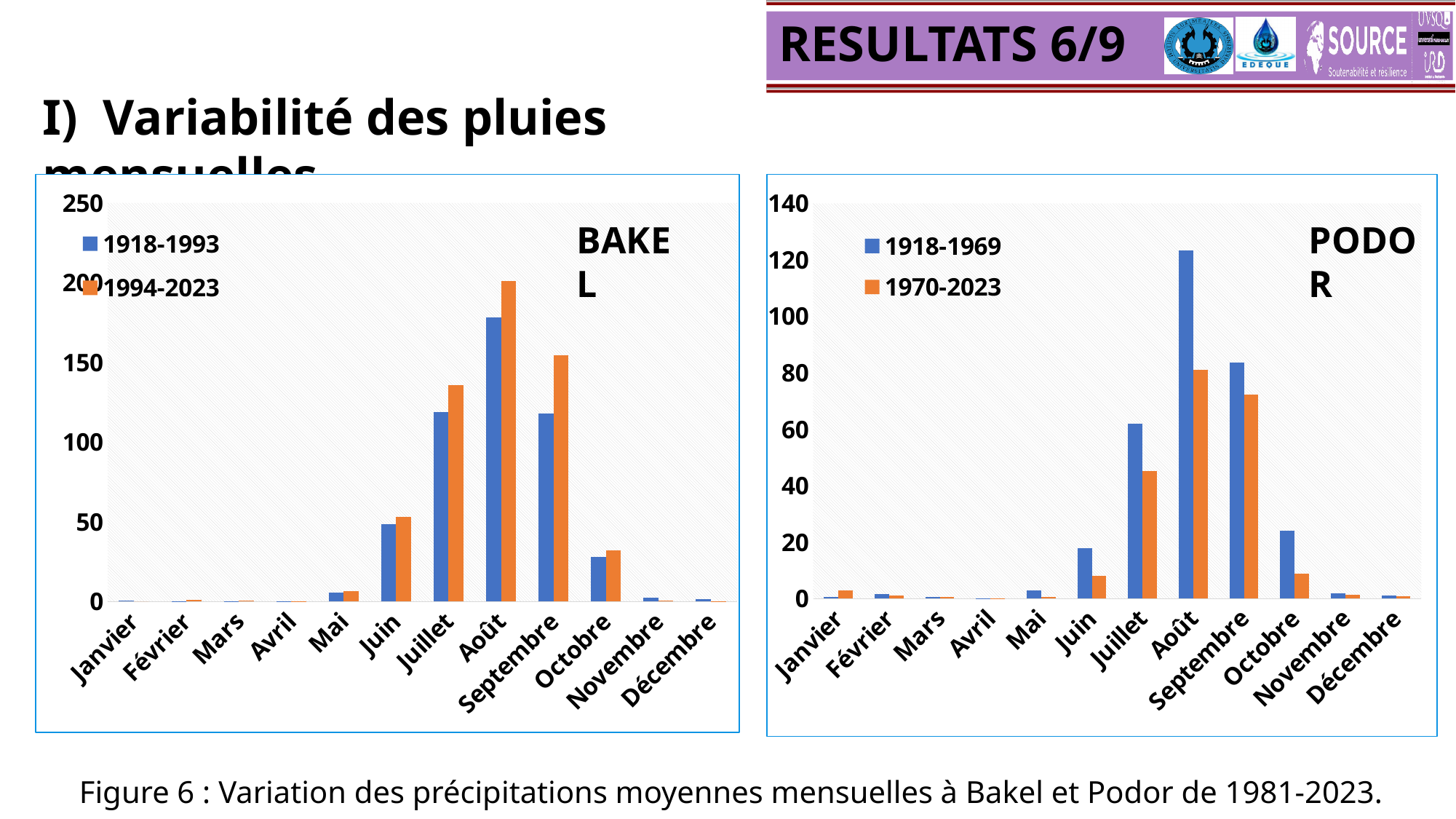
How many months are shown on the x axis of the BAKEL chart? 12 In the PODOR chart, which month has the highest value for the 1918-1969 series? Août In the BAKEL chart, is the value for Juillet in the 1994-2023 series greater or less than 150? less What are the two legend entries of the BAKEL chart? 1918-1993 and 1994-2023 How many series does the legend of the PODOR chart list? 2 In the PODOR chart, is the value for Août in the 1918-1969 series greater or less than 100? greater In the BAKEL chart, for Septembre, which series has the larger value: 1918-1993 or 1994-2023? 1994-2023 In the PODOR chart, is the value for Août in the 1970-2023 series greater or less than 100? less What kind of chart is the BAKEL chart on the left? bar chart In the BAKEL chart, which month has the highest value for the 1994-2023 series? Août In the PODOR chart, for Juillet, which series has the larger value: 1918-1969 or 1970-2023? 1918-1969